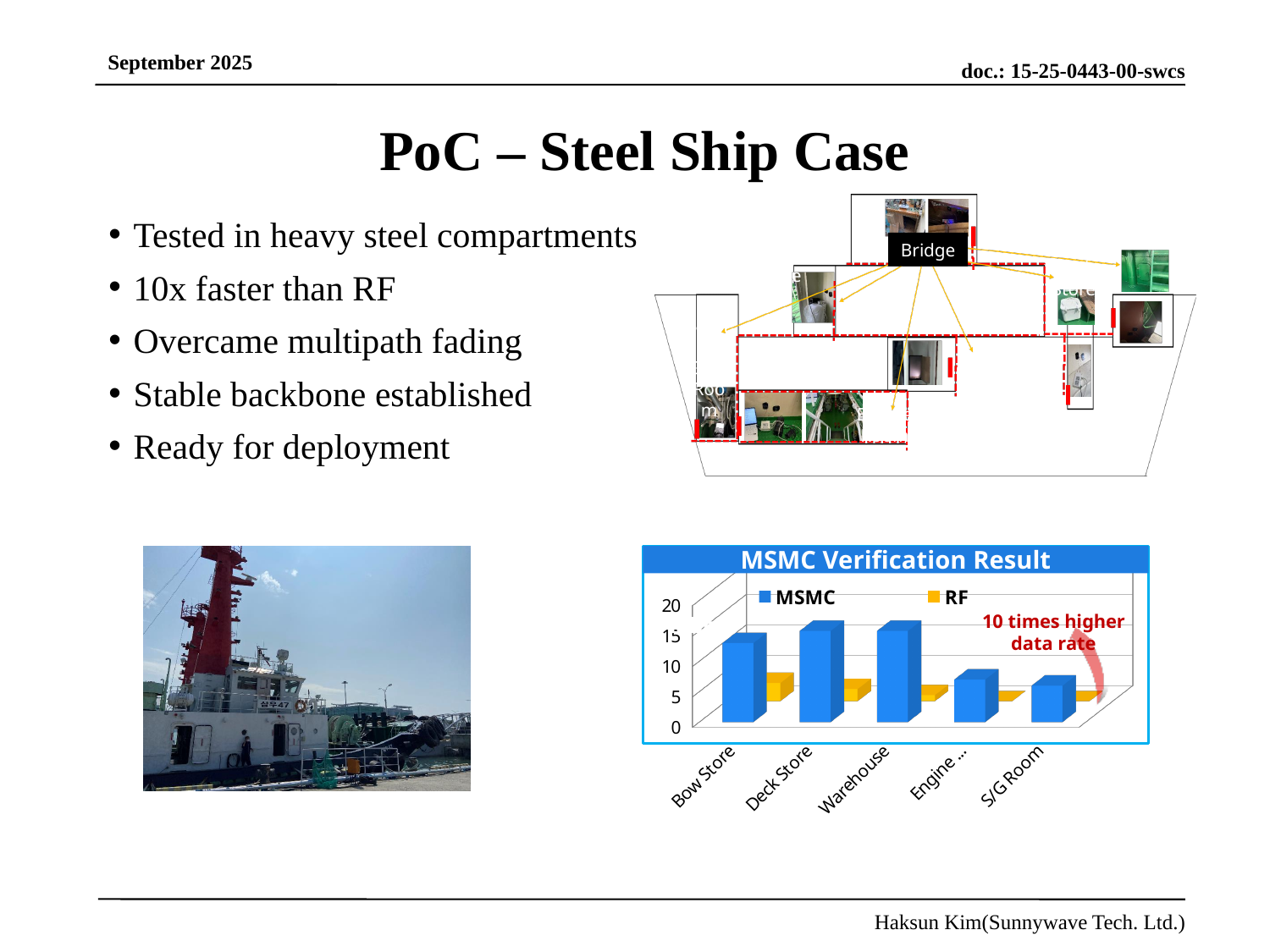
What kind of chart is shown under the title 'MSMC Verification Result'? bar chart How many series does the legend of the 'MSMC Verification Result' chart list? 2 In the 'MSMC Verification Result' chart, is the RF value for Bow Store greater or less than 5? less How many categories are shown on the x axis of the 'MSMC Verification Result' chart? 5 In the 'MSMC Verification Result' chart, is the MSMC value for S/G Room greater or less than 10? less What is the title of the chart on the slide? MSMC Verification Result What are the two series named in the legend of the 'MSMC Verification Result' chart? MSMC and RF In the 'MSMC Verification Result' chart, is the MSMC value for Bow Store greater or less than 10? greater In the 'MSMC Verification Result' chart, which series has the larger value for Deck Store, MSMC or RF? MSMC In the 'MSMC Verification Result' chart, which is larger, the MSMC value for Warehouse or the MSMC value for S/G Room? Warehouse